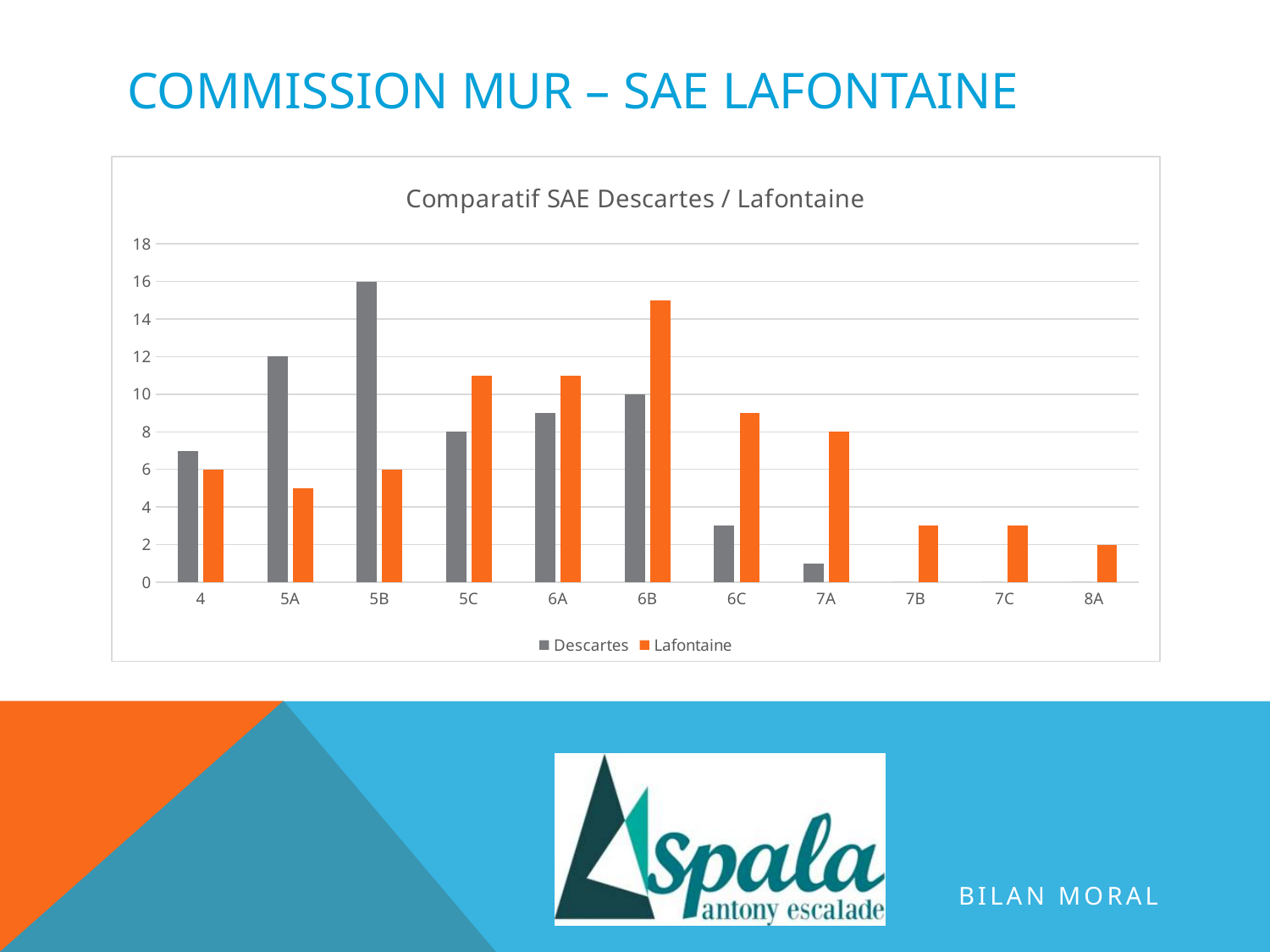
Is the Lafontaine value for 6B greater or less than 14? greater What is the title of the chart? Comparatif SAE Descartes / Lafontaine What is the Lafontaine value for 7A? 8 What type of chart is shown on the slide? bar chart What is the Lafontaine value for 8A? 2 How many categories are shown on the x axis? 11 How many series does the legend list? 2 For 6C, which series has the larger value, Descartes or Lafontaine? Lafontaine What is the Descartes value for 5A? 12 Which category has the highest Lafontaine value? 6B Which category has the highest Descartes value? 5B What is the Descartes value for 5B? 16